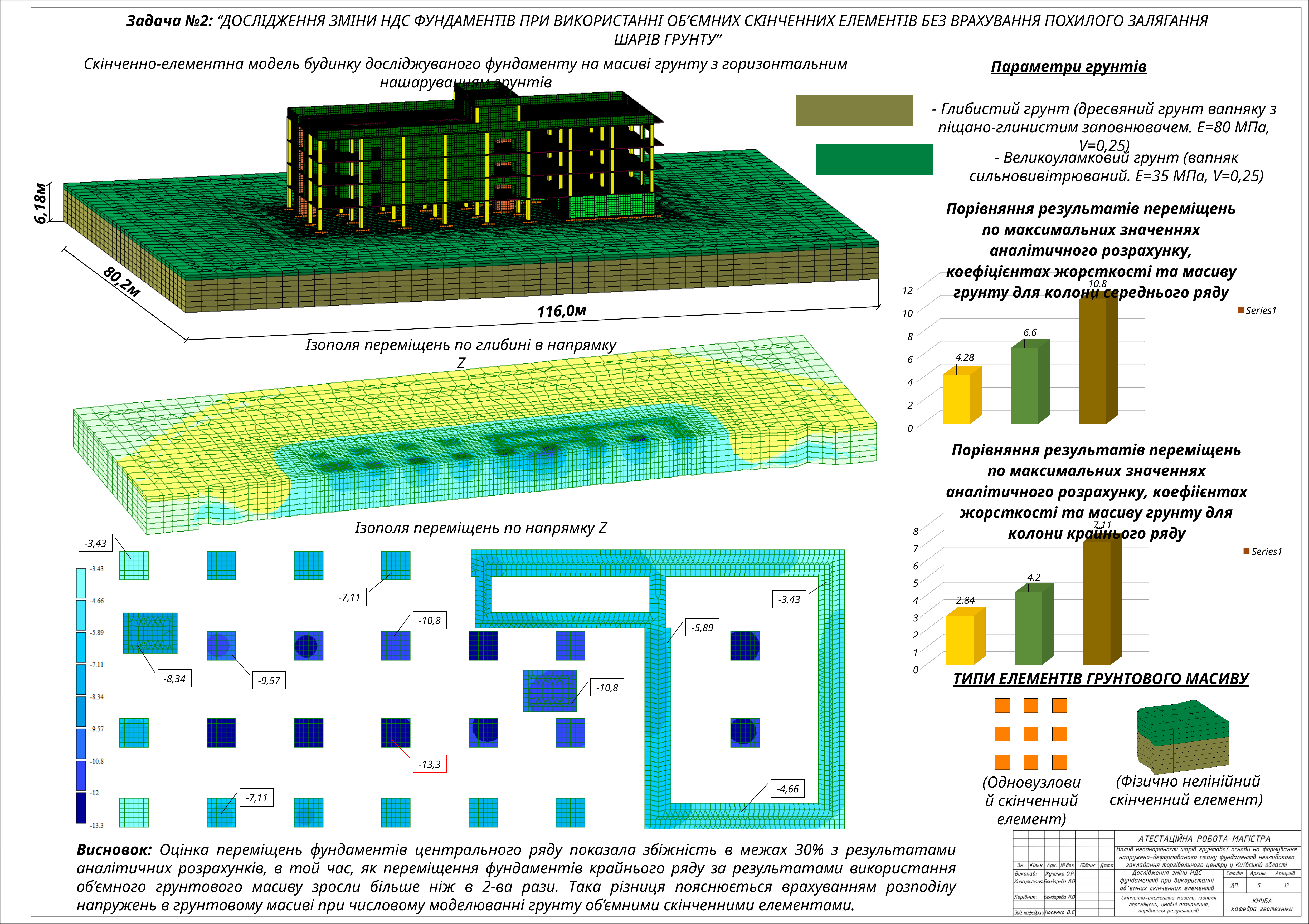
What type of chart is used to compare the displacement results for the middle-row column? bar chart In the upper bar chart (for the middle-row column), what is the value of the third (brown) bar? 10.8 In the upper bar chart (for the middle-row column), what is the difference between the third bar and the first bar? 6.52 In the upper bar chart (for the middle-row column), what is the value of the second (green) bar? 6.6 In the lower bar chart (for the edge-row column), what is the value of the first (yellow) bar? 2.84 In the upper bar chart (for the middle-row column), what is the value of the first (yellow) bar? 4.28 How many bars are plotted in the lower bar chart (for the edge-row column)? 3 In the lower bar chart (for the edge-row column), which bar has the lowest value? the first (yellow) bar, 2.84 In the lower bar chart (for the edge-row column), what is the value of the third (brown) bar? 7.11 What legend entry is shown next to the upper bar chart (for the middle-row column)? Series1 In the lower bar chart (for the edge-row column), what is the difference between the second bar and the first bar? 1.36 In the upper bar chart (for the middle-row column), which bar has the highest value? the third (brown) bar, 10.8